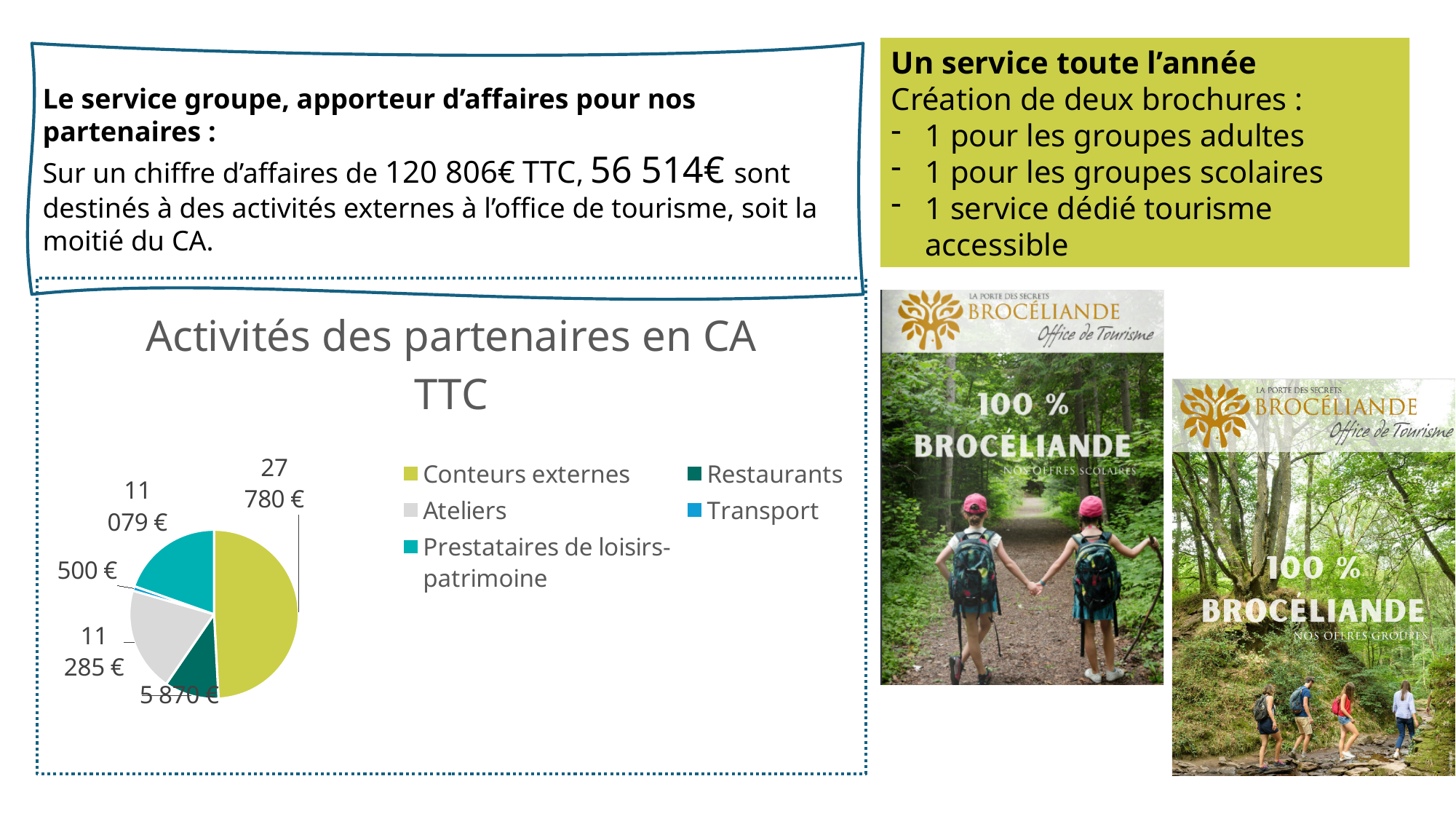
What is the value for Conteurs externes in the pie chart? 27 780 € What is the value for Restaurants in the pie chart? 5 870 € What kind of chart is shown on the slide? pie chart Which category has the largest slice of the pie chart? Conteurs externes Which is larger, the value for Restaurants or the value for Ateliers? Ateliers What is the value for Transport in the pie chart? 500 € What is the difference between the values for Conteurs externes and Ateliers? 16 495 € Which category has the smallest slice of the pie chart? Transport What is the value for Prestataires de loisirs-patrimoine in the pie chart? 11 079 € What is the title of the chart? Activités des partenaires en CA TTC How many categories does the legend of the pie chart list? 5 What is the value for Ateliers in the pie chart? 11 285 €